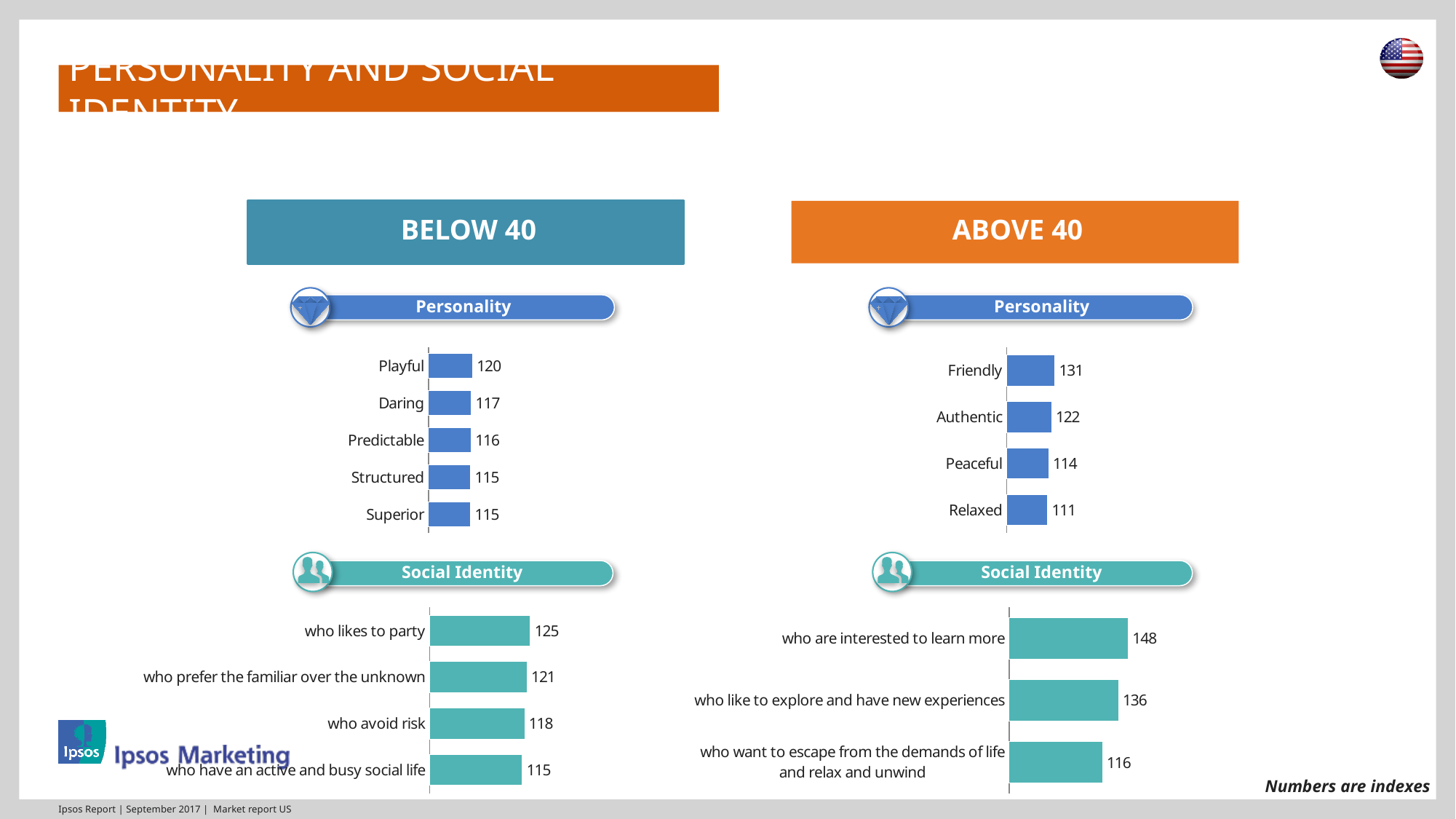
In the Below 40 Personality chart, what is the index for Playful? 120 What type of chart is used for the Below 40 Social Identity data? Bar chart In the Above 40 Personality chart, what is the index for Authentic? 122 In the Above 40 Personality chart, what is the difference between the index for Friendly and the index for Relaxed? 20 In the Above 40 Personality chart, which trait has the lowest index? Relaxed How many categories are shown in the Above 40 Social Identity chart? 3 How many traits are shown in the Below 40 Personality chart? 5 Which is larger: the index for Playful in the Below 40 Personality chart or the index for Friendly in the Above 40 Personality chart? Friendly In the Above 40 Social Identity chart, which category has the highest index? who are interested to learn more In the Above 40 Social Identity chart, what is the index for 'who like to explore and have new experiences'? 136 In the Below 40 Social Identity chart, which category has the highest index? who likes to party In the Below 40 Social Identity chart, what is the difference between 'who likes to party' and 'who avoid risk'? 7